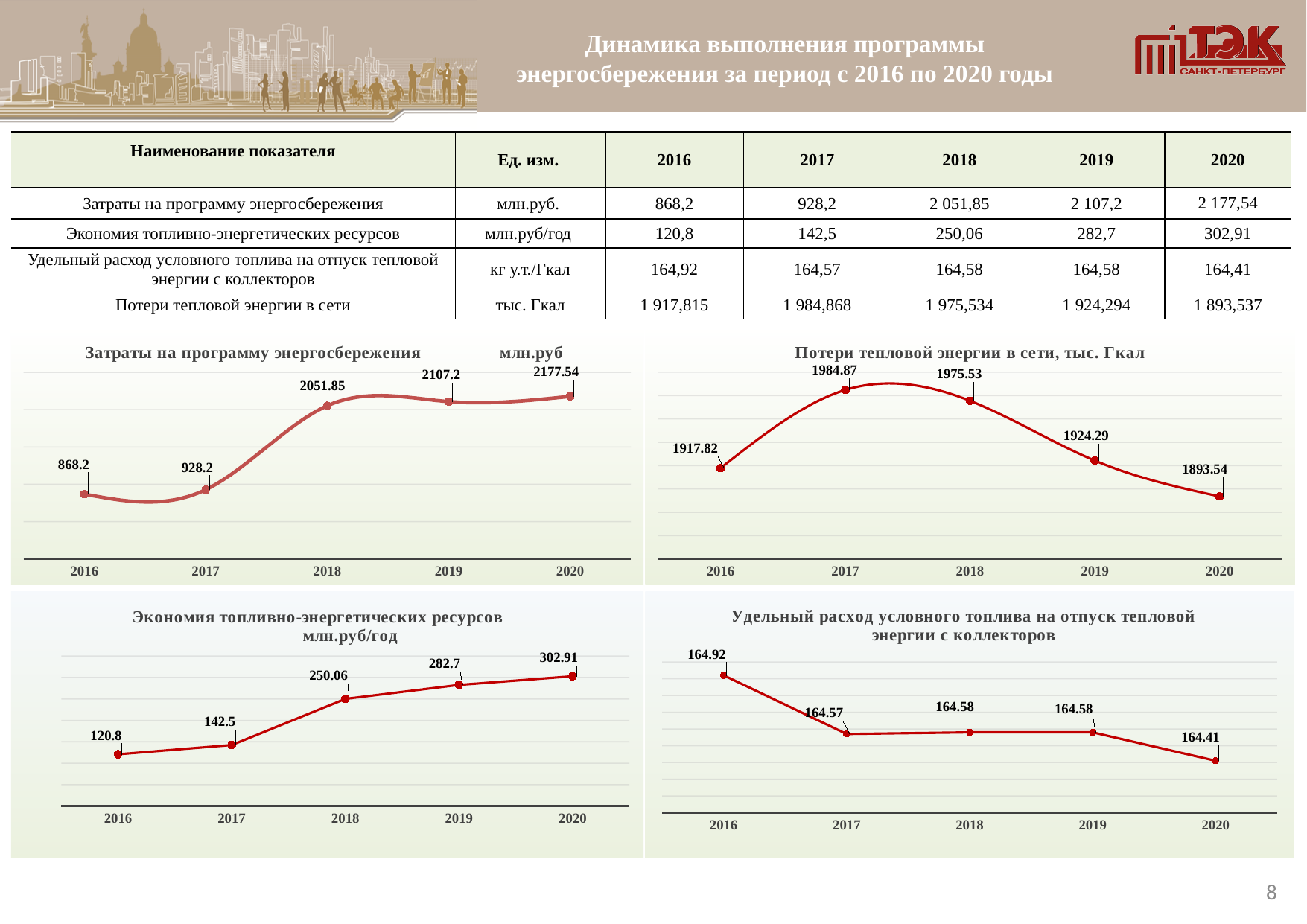
On the top-left chart (Затраты на программу энергосбережения), which year has the lowest value? 2016 On the bottom-left chart (Экономия топливно-энергетических ресурсов), what is the difference between the 2018 and 2017 values? 107.56 On the top-right chart (Потери тепловой энергии в сети), do the values rise or fall from 2017 to 2020? fall On the bottom-left chart (Экономия топливно-энергетических ресурсов), do the values rise or fall from 2016 to 2020? rise On the top-left chart (Затраты на программу энергосбережения), what is the difference between the 2020 and 2016 values? 1309.34 On the top-right chart (Потери тепловой энергии в сети), what is the value for 2017? 1984.87 How many data points are plotted on the top-left chart (Затраты на программу энергосбережения)? 5 On the bottom-left chart (Экономия топливно-энергетических ресурсов), what is the value for 2019? 282.7 On the top-left chart (Затраты на программу энергосбережения), what is the value for 2018? 2051.85 On the top-right chart (Потери тепловой энергии в сети), which year has the highest value? 2017 On the bottom-right chart (Удельный расход условного топлива), which year has the highest value? 2016 On the bottom-right chart (Удельный расход условного топлива), what is the value for 2020? 164.41